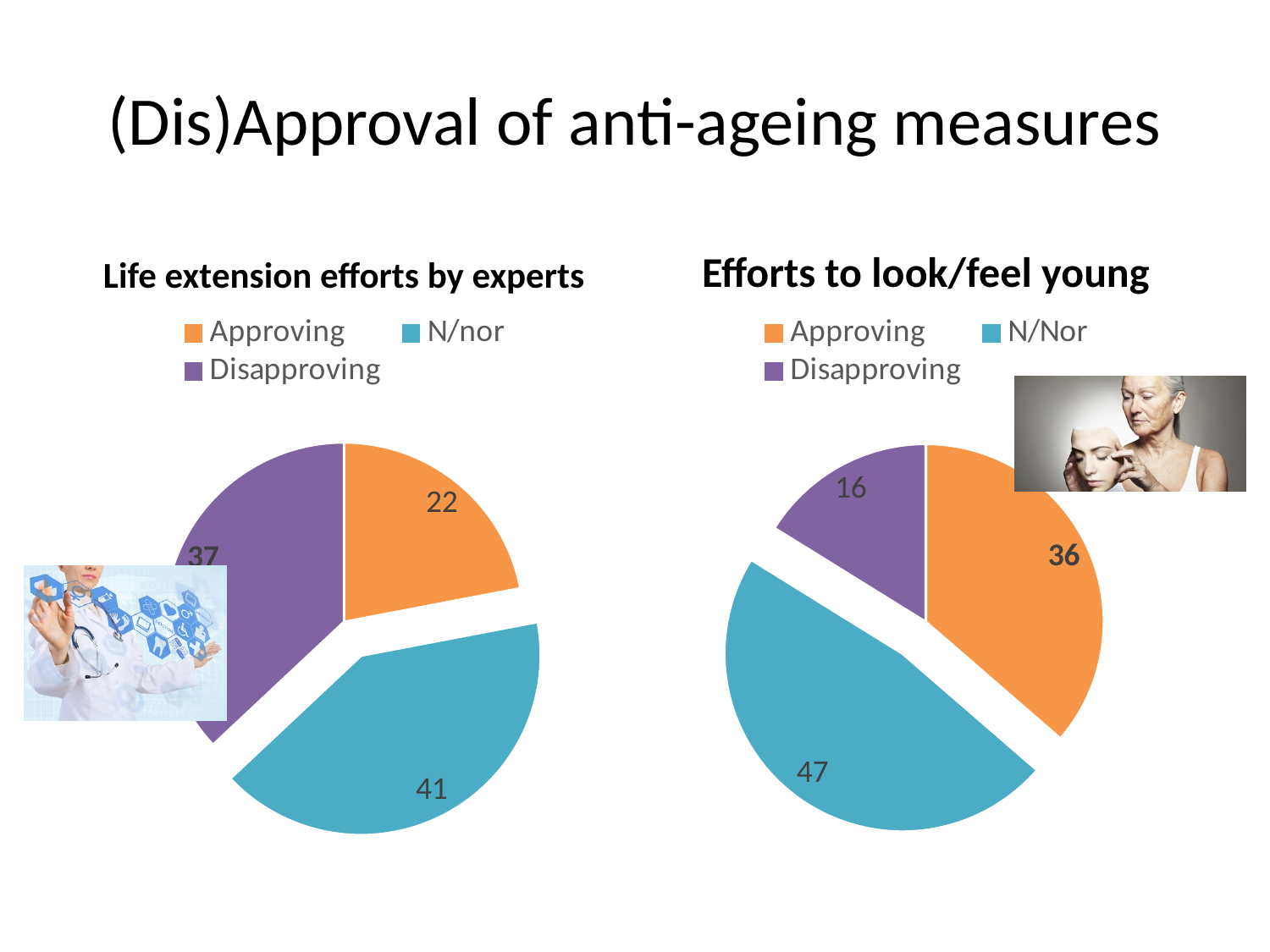
In the 'Life extension efforts by experts' chart, what colour is the Disapproving slice? Purple In the 'Life extension efforts by experts' chart, what is the difference between the N/nor and Approving values? 19 In the 'Life extension efforts by experts' chart, what is the value for Approving? 22 In the 'Efforts to look/feel young' chart, what is the difference between the Approving and Disapproving values? 20 What type of chart is 'Life extension efforts by experts'? Pie chart In the 'Life extension efforts by experts' chart, which category has the largest slice? N/nor Which chart has the larger Approving value, 'Life extension efforts by experts' or 'Efforts to look/feel young'? Efforts to look/feel young In the 'Life extension efforts by experts' chart, what is the value for Disapproving? 37 In the 'Efforts to look/feel young' chart, what is the value for N/Nor? 47 In the 'Efforts to look/feel young' chart, which category has the smallest slice? Disapproving How many categories does the 'Efforts to look/feel young' chart show? 3 In the 'Efforts to look/feel young' chart, what is the value for Disapproving? 16